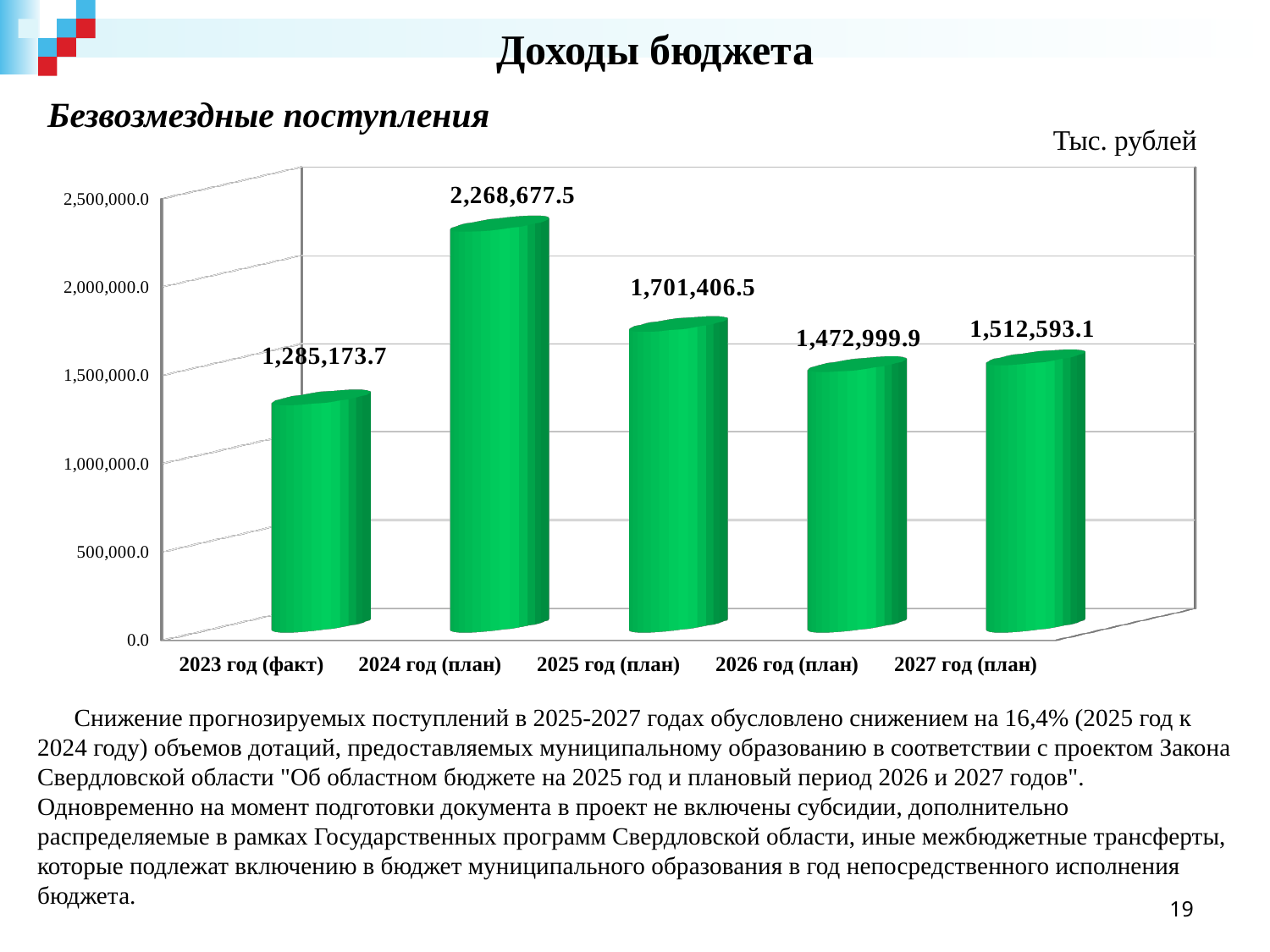
What is the value for 2024 год (план)? 2,268,677.5 What kind of chart is shown on the slide? bar chart What unit of measurement is indicated above the chart? Тыс. рублей What is the value for 2026 год (план)? 1,472,999.9 Is the value for 2025 год (план) greater or less than 1,500,000.0? greater Which is larger, the value for 2025 год (план) or 2027 год (план)? 2025 год (план) What is the difference between the values for 2027 год (план) and 2026 год (план)? 39,593.2 Which year has the highest value? 2024 год (план) How many years are shown on the chart? 5 Which year has the lowest value? 2023 год (факт) What is the value for 2023 год (факт)? 1,285,173.7 What is the difference between the values for 2024 год (план) and 2023 год (факт)? 983,503.8